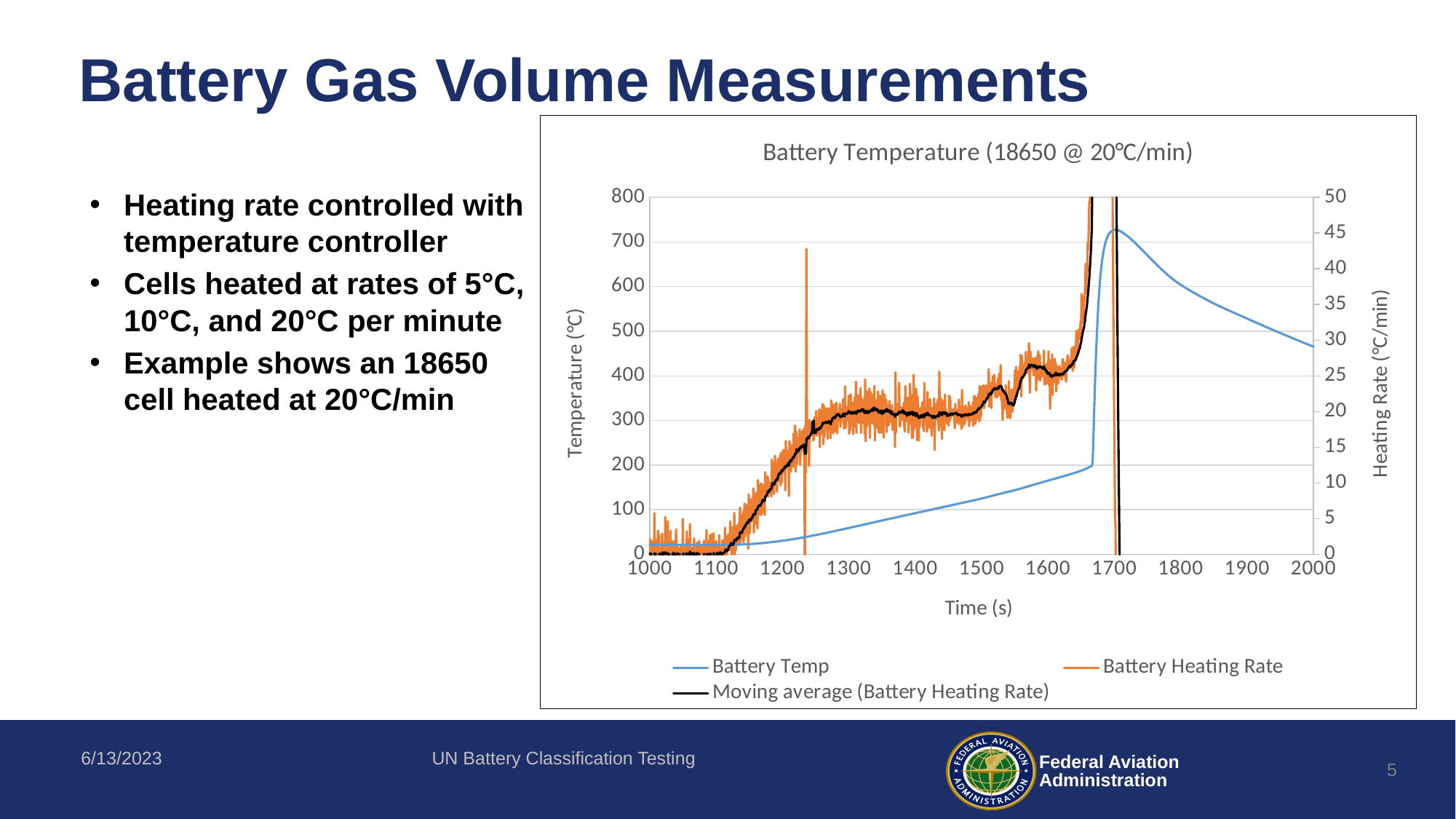
Is the Moving average (Battery Heating Rate) value at 1600 s greater or less than 20 °C/min? greater What is the title of the chart? Battery Temperature (18650 @ 20°C/min) How many series does the chart legend list? 3 Is the Battery Temp value at 1100 s greater or less than 100 °C? less Does the Battery Temp series rise or fall between 1750 s and 2000 s? fall Is the peak Battery Temp value greater or less than 600 °C? greater Does the Battery Temp series rise or fall between 1000 s and 1600 s? rise What is the label of the x axis of the chart? Time (s) What kind of chart is shown on the slide? Line chart